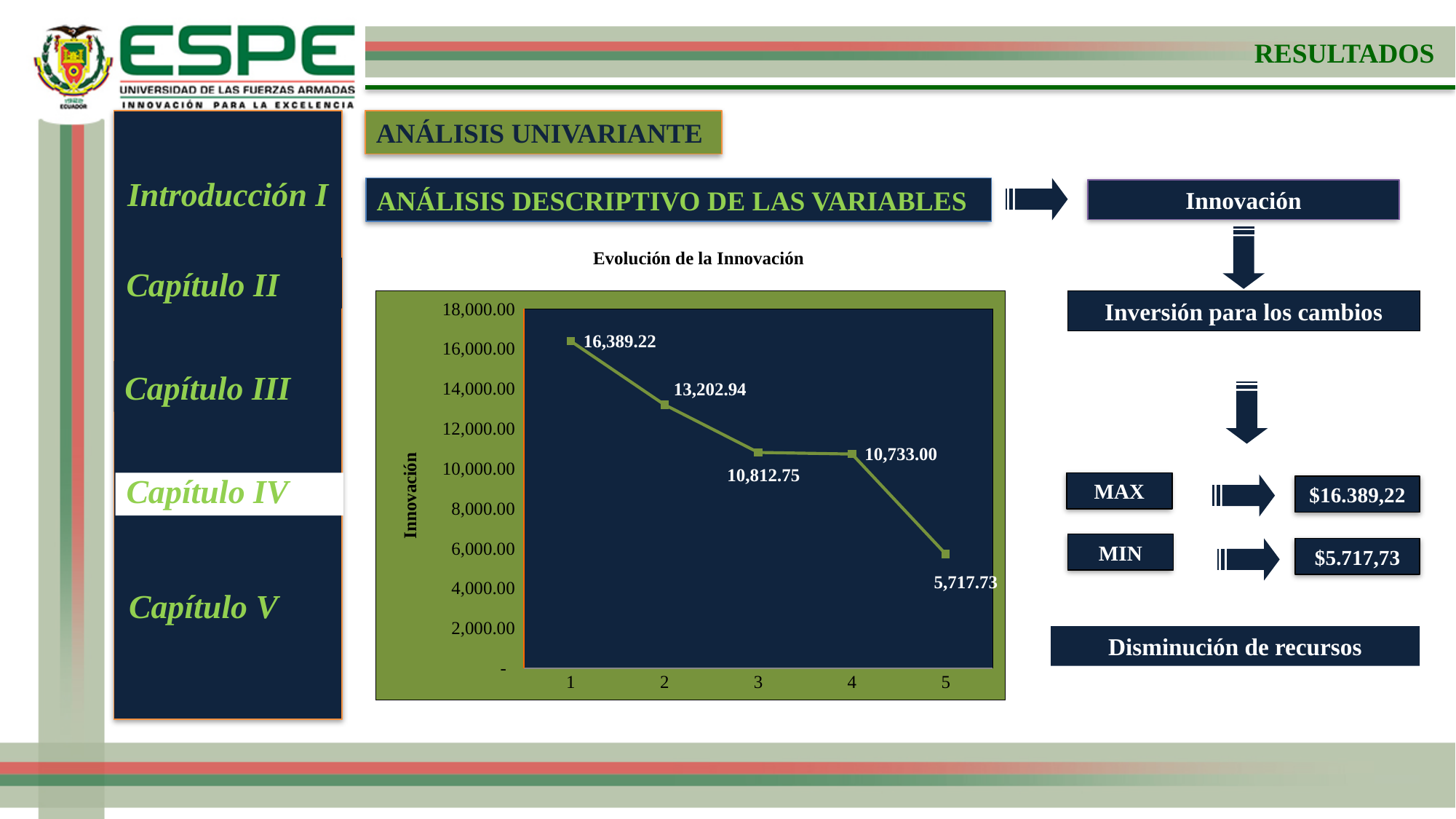
Which point has the highest Innovación value? 1 What is the value of Innovación at point 1? 16,389.22 What type of chart is shown on the slide? Line chart How many data points are plotted in the chart? 5 What is the value of Innovación at point 5? 5,717.73 What is the difference between the Innovación values at point 1 and point 2? 3,186.28 What is the difference between the Innovación values at point 4 and point 5? 5,015.27 Is the Innovación value at point 5 greater or less than 6,000.00? less What is the title of the chart? Evolución de la Innovación Which is larger, the Innovación value at point 2 or at point 4? Point 2 Which point has the lowest Innovación value? 5 What is the value of Innovación at point 3? 10,812.75